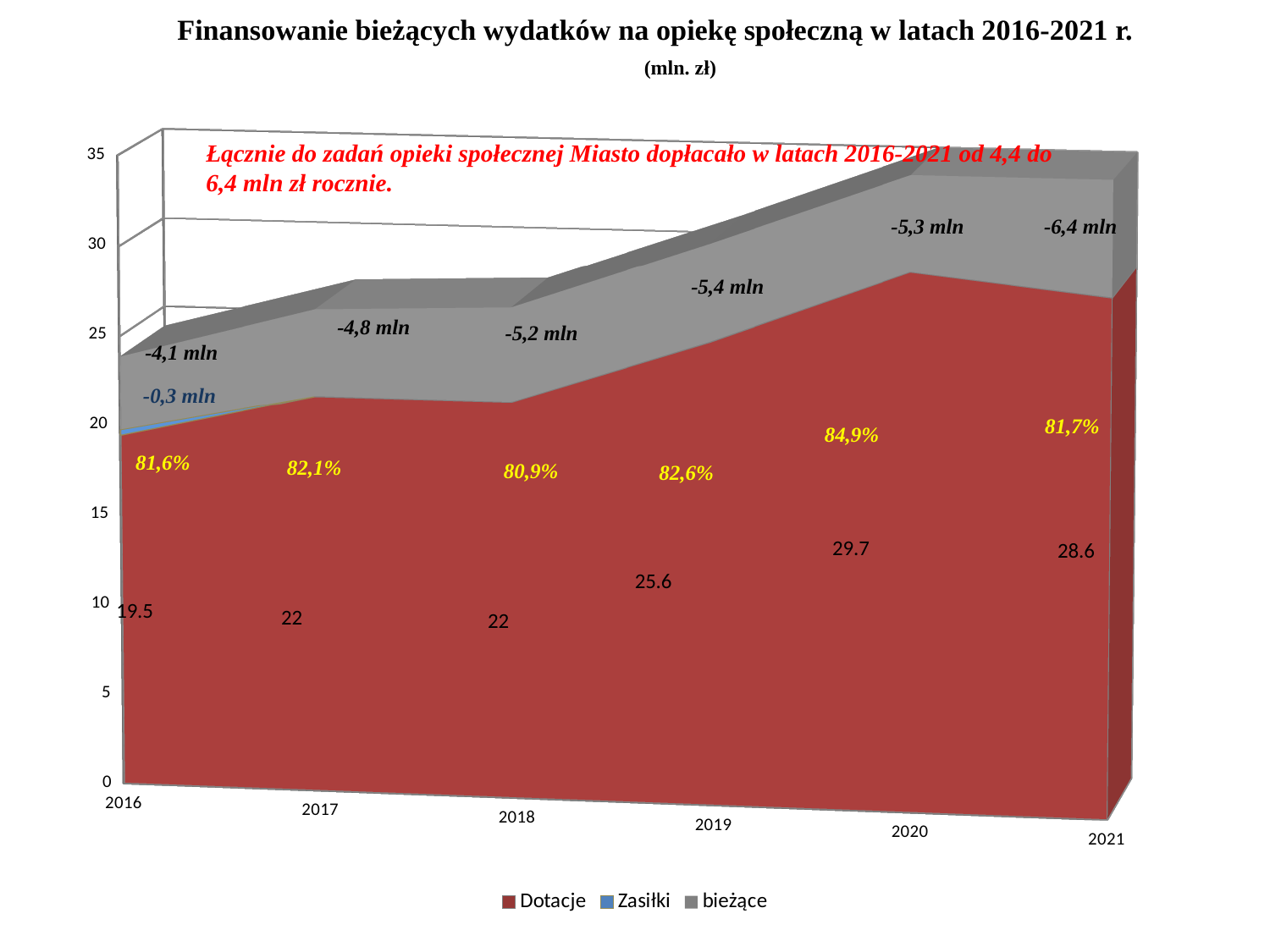
How many series does the legend list? 3 What is the value of Dotacje for 2021? 28.6 What kind of chart is shown on the slide? area chart Which series is shown in red in the legend? Dotacje Does the Dotacje value rise or fall from 2016 to 2020? rise Which is larger, the Dotacje value for 2019 or for 2018? 2019 Which year has the lowest Dotacje value? 2016 How many years are shown on the x axis? 6 What is the value of Dotacje for 2016? 19.5 What is the value of Dotacje for 2019? 25.6 What is the difference between the Dotacje values for 2020 and 2021? 1.1 Which year has the highest Dotacje value? 2020